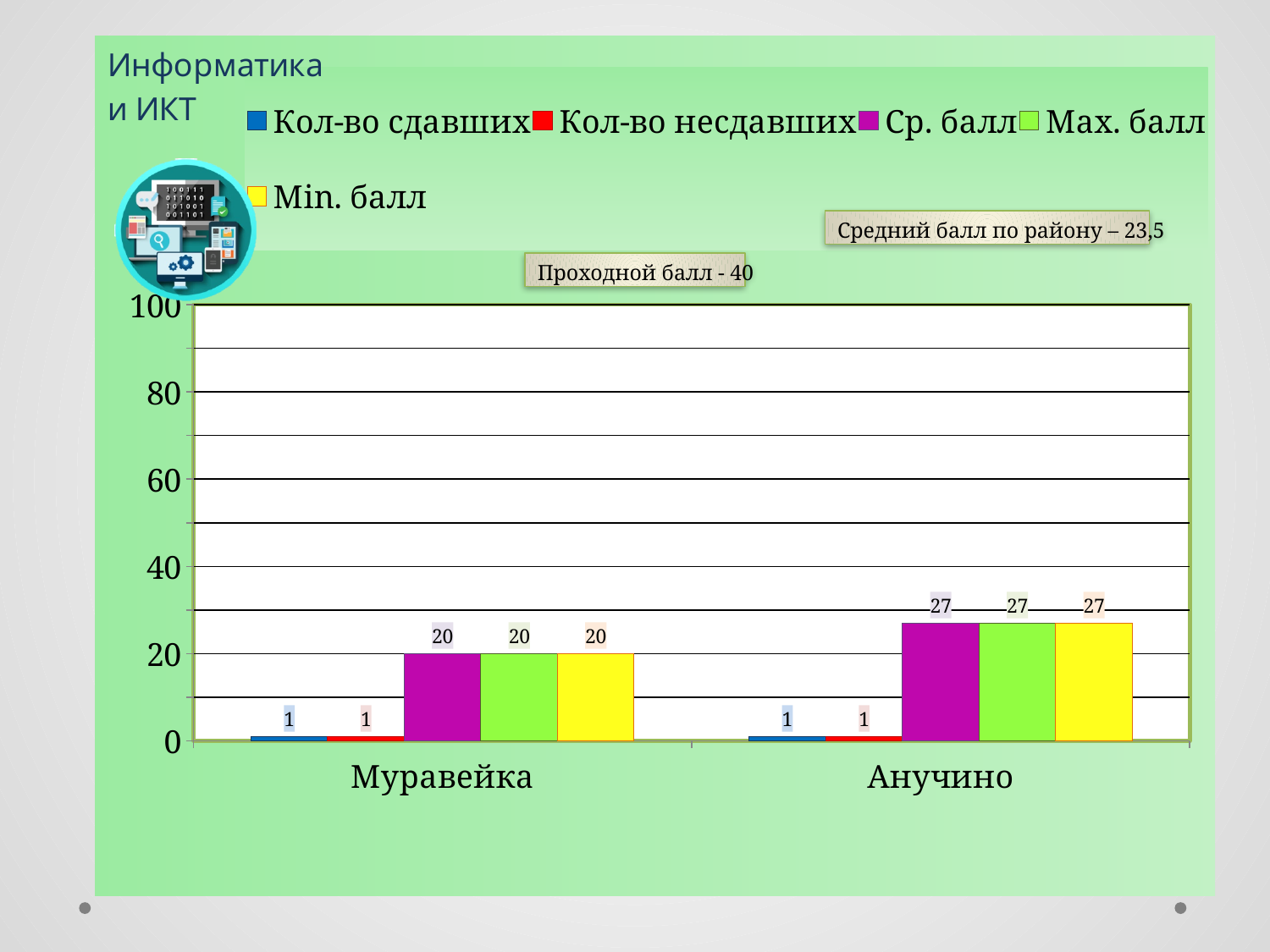
Which category has the higher Max. балл, Муравейка or Анучино? Анучино How many series does the legend list? 5 How many categories are shown on the x axis? 2 Is the value of Max. балл for Анучино greater or less than 40? less What is the difference between the Ср. балл for Анучино and for Муравейка? 7 What kind of chart is shown on the slide? bar chart What is the value of Кол-во сдавших for Анучино? 1 What is the value of Ср. балл for Анучино? 27 What is the value of Min. балл for Муравейка? 20 What passing score (Проходной балл) is stated on the slide? 40 What is the value of Ср. балл for Муравейка? 20 Which series is shown in yellow in the legend? Min. балл